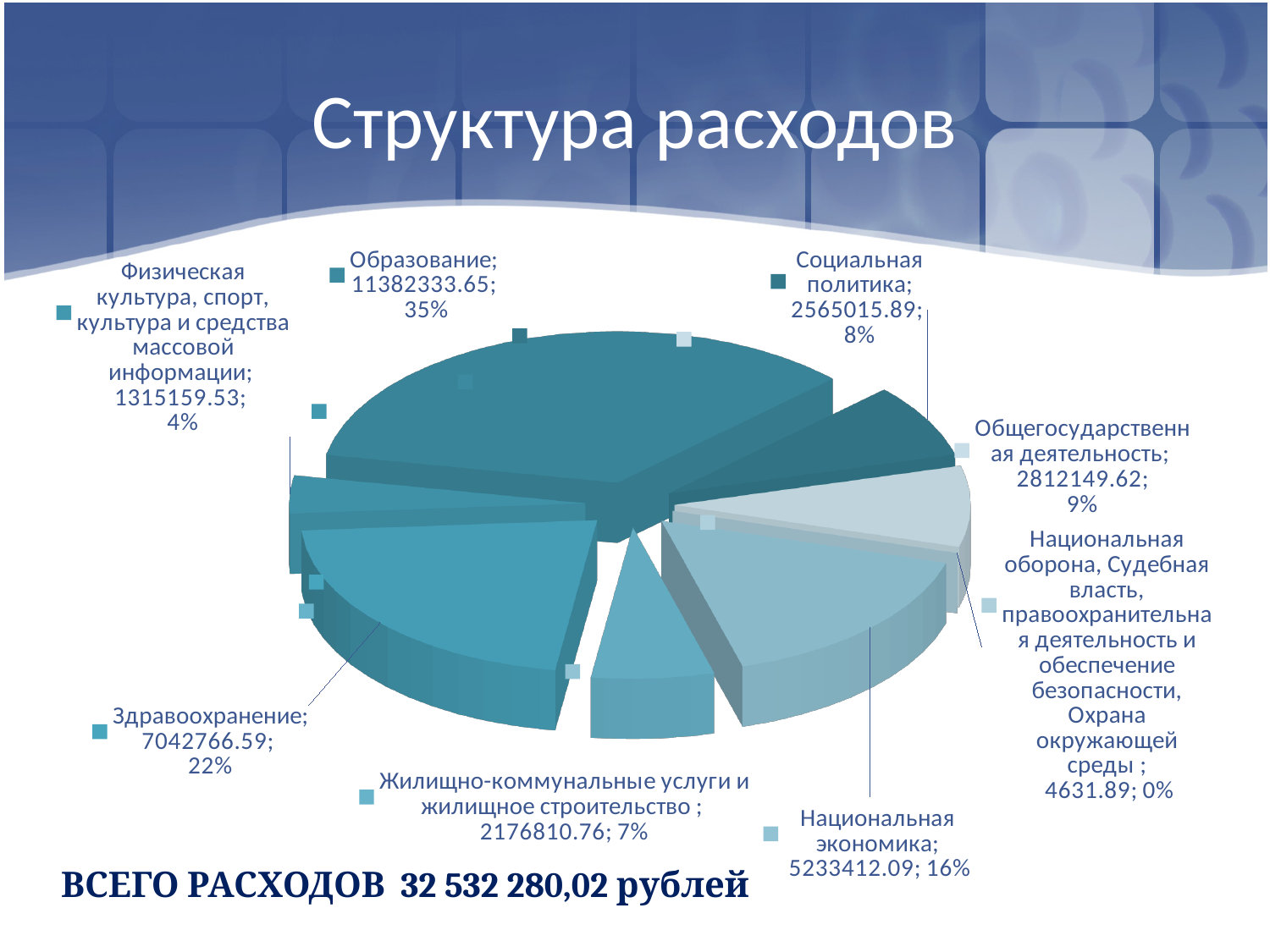
Which category has the smallest share of the pie? Национальная оборона, Судебная власть, правоохранительная деятельность и обеспечение безопасности, Охрана окружающей среды What is the title of the chart? Структура расходов What is the value for Национальная экономика? 5233412.09 How many categories (slices) does the pie chart have? 8 What kind of chart is shown on the slide? Pie chart Which is larger: Общегосударственная деятельность or Социальная политика? Общегосударственная деятельность What is the value for Образование? 11382333.65 What is the value for Жилищно-коммунальные услуги и жилищное строительство? 2176810.76 Which category has the largest share of the pie? Образование What share of the pie does Социальная политика represent? 8% What share of the pie does Здравоохранение represent? 22% What is the difference between the values for Здравоохранение and Национальная экономика? 1809354.50